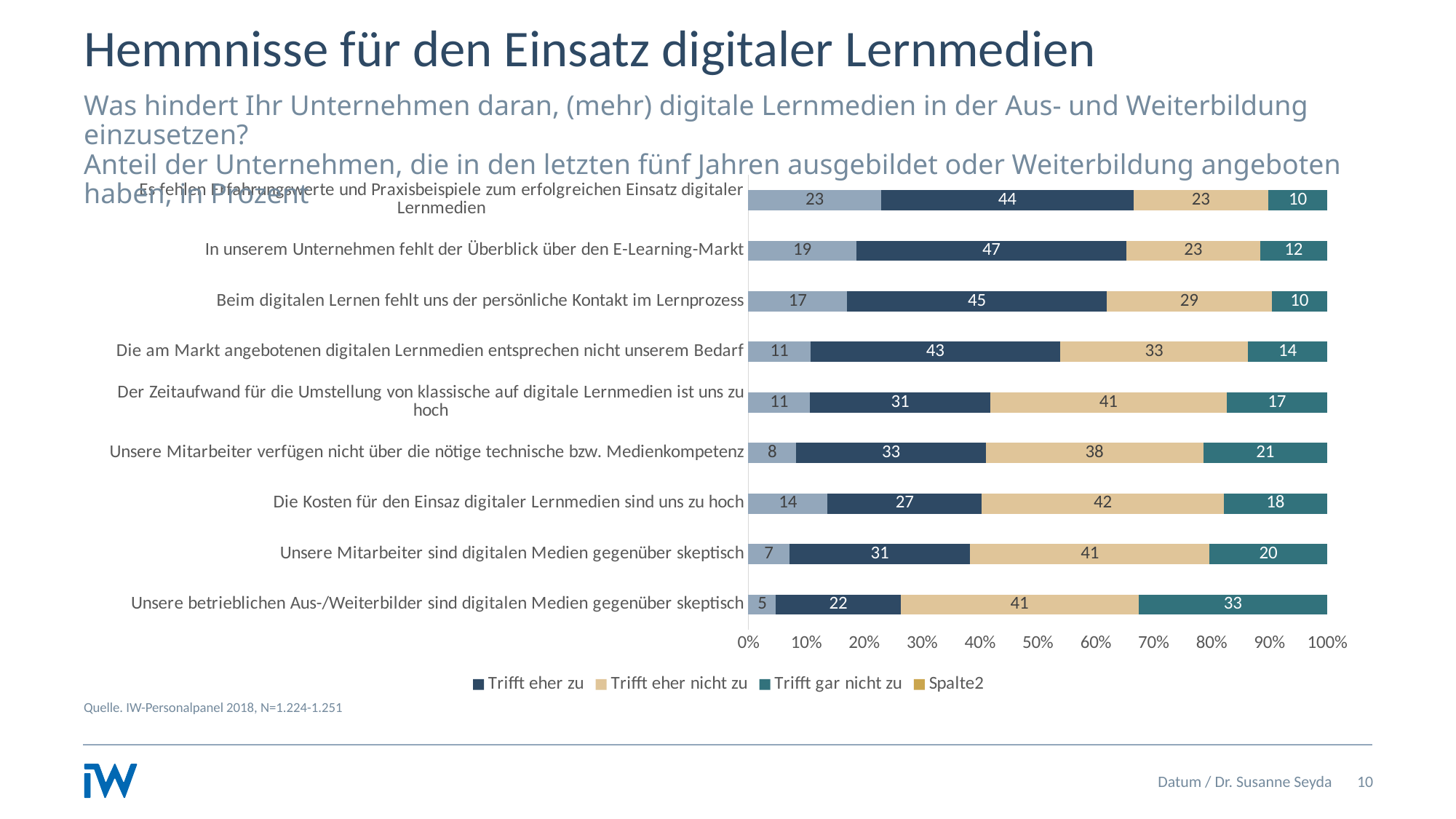
What is the 'Trifft gar nicht zu' value for 'Unsere betrieblichen Aus-/Weiterbilder sind digitalen Medien gegenüber skeptisch'? 33 What data source is cited below the chart? IW-Personalpanel 2018, N=1.224-1.251 What is the difference between the 'Trifft gar nicht zu' values for 'Unsere Mitarbeiter verfügen nicht über die nötige technische bzw. Medienkompetenz' and 'Die Kosten für den Einsaz digitaler Lernmedien sind uns zu hoch'? 3 What is the 'Trifft eher nicht zu' value for 'Unsere Mitarbeiter verfügen nicht über die nötige technische bzw. Medienkompetenz'? 38 Which statement has the lowest 'Trifft eher zu' value? Unsere betrieblichen Aus-/Weiterbilder sind digitalen Medien gegenüber skeptisch What is the 'Trifft eher zu' value for 'In unserem Unternehmen fehlt der Überblick über den E-Learning-Markt'? 47 How many categories (statements) are plotted in the chart? 9 What type of chart is shown on the slide? Stacked bar chart Which statement has the highest 'Trifft gar nicht zu' value? Unsere betrieblichen Aus-/Weiterbilder sind digitalen Medien gegenüber skeptisch Which statement has the highest 'Trifft eher zu' value? In unserem Unternehmen fehlt der Überblick über den E-Learning-Markt How many series does the chart legend list? 4 Which has the larger 'Trifft eher nicht zu' value: 'Beim digitalen Lernen fehlt uns der persönliche Kontakt im Lernprozess' or 'Die am Markt angebotenen digitalen Lernmedien entsprechen nicht unserem Bedarf'? Die am Markt angebotenen digitalen Lernmedien entsprechen nicht unserem Bedarf